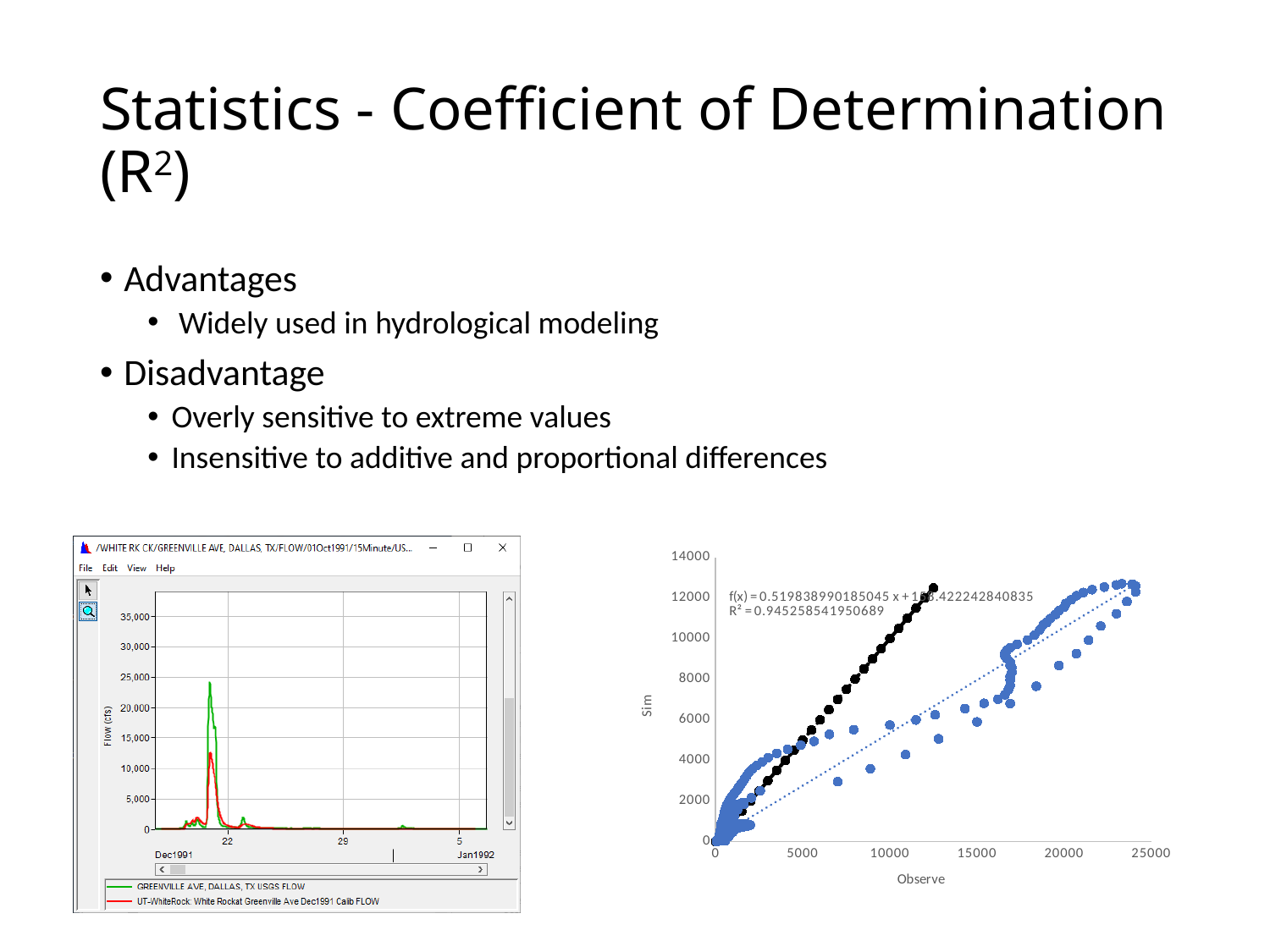
In the scatter chart on the right, what is the label of the horizontal axis? Observe In the left chart, is the peak value of the red UT-WhiteRock Calib FLOW line greater or less than 15,000? less In the left chart, what is the label of the vertical axis? Flow (cfs) In the scatter chart on the right, what is the slope (coefficient of x) in the fitted equation f(x) shown on the chart? 0.519838990185045 In the scatter chart on the right, what is the label of the vertical axis? Sim What kind of chart is the chart on the right of the slide? scatter chart In the scatter chart on the right, what R² value is printed on the chart? 0.945258541950689 In the left chart, is the peak value of the green GREENVILLE AVE, DALLAS, TX USGS FLOW line greater or less than 20,000? greater In the scatter chart on the right, do the Sim values generally rise or fall as Observe increases? rise What kind of chart is shown in the window on the left of the slide? line chart In the left chart, which series reaches the higher peak flow? GREENVILLE AVE, DALLAS, TX USGS FLOW How many series does the legend of the left chart list? 2